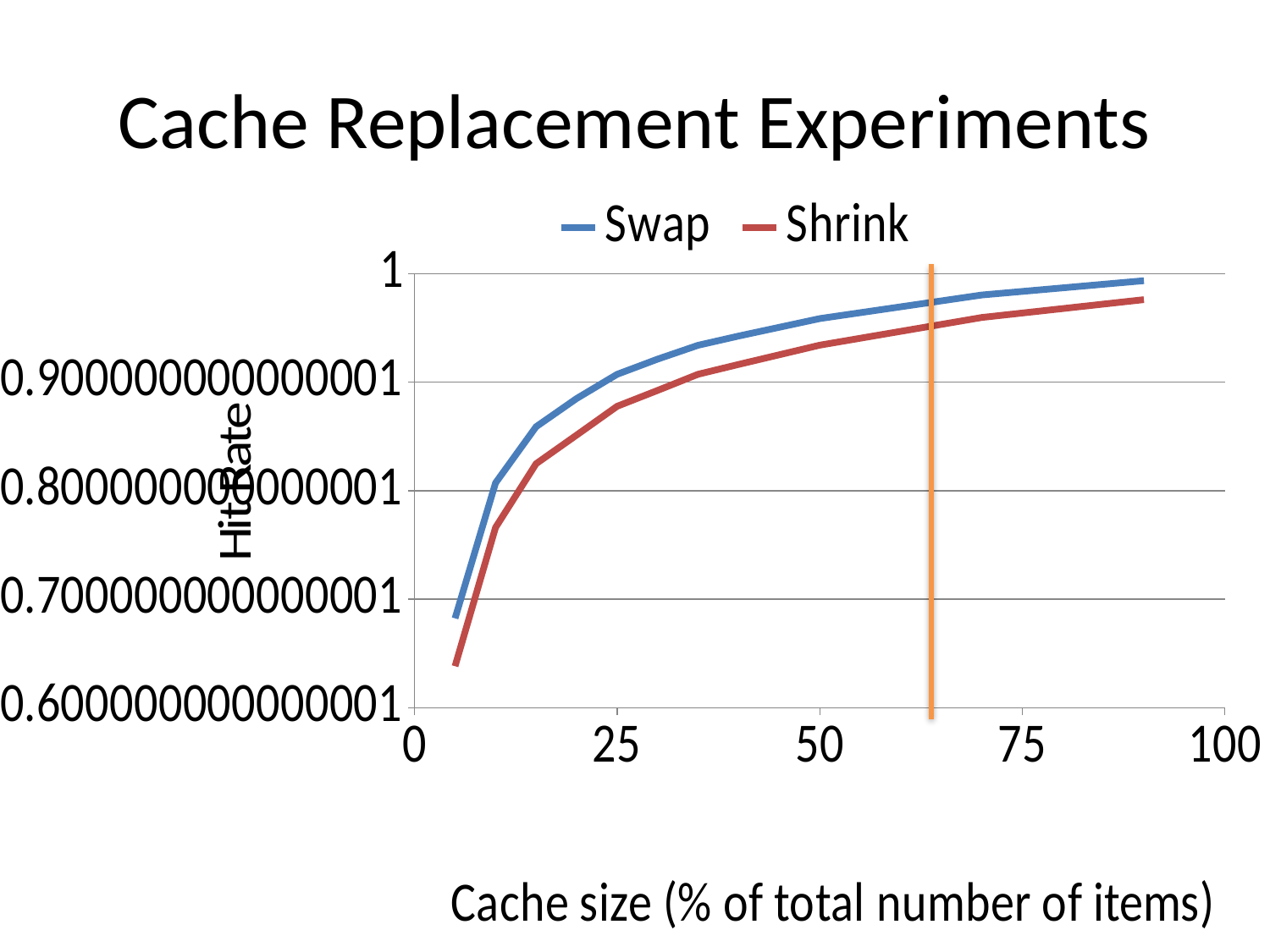
Do the hit rate values rise or fall as cache size increases? rise How many series does the legend list? 2 Which series has the higher hit rate at a cache size of 50? Swap Is the Shrink hit rate at a cache size of 90 greater or less than 0.9? greater What kind of chart is shown on the slide? line chart Which series has the lower hit rate at a cache size of 25? Shrink What are the two series named in the legend? Swap and Shrink Is the Shrink hit rate at a cache size of 10 greater or less than 0.8? less Is the Shrink hit rate at a cache size of 5 greater or less than 0.7? less What is the title of the chart? Cache Replacement Experiments